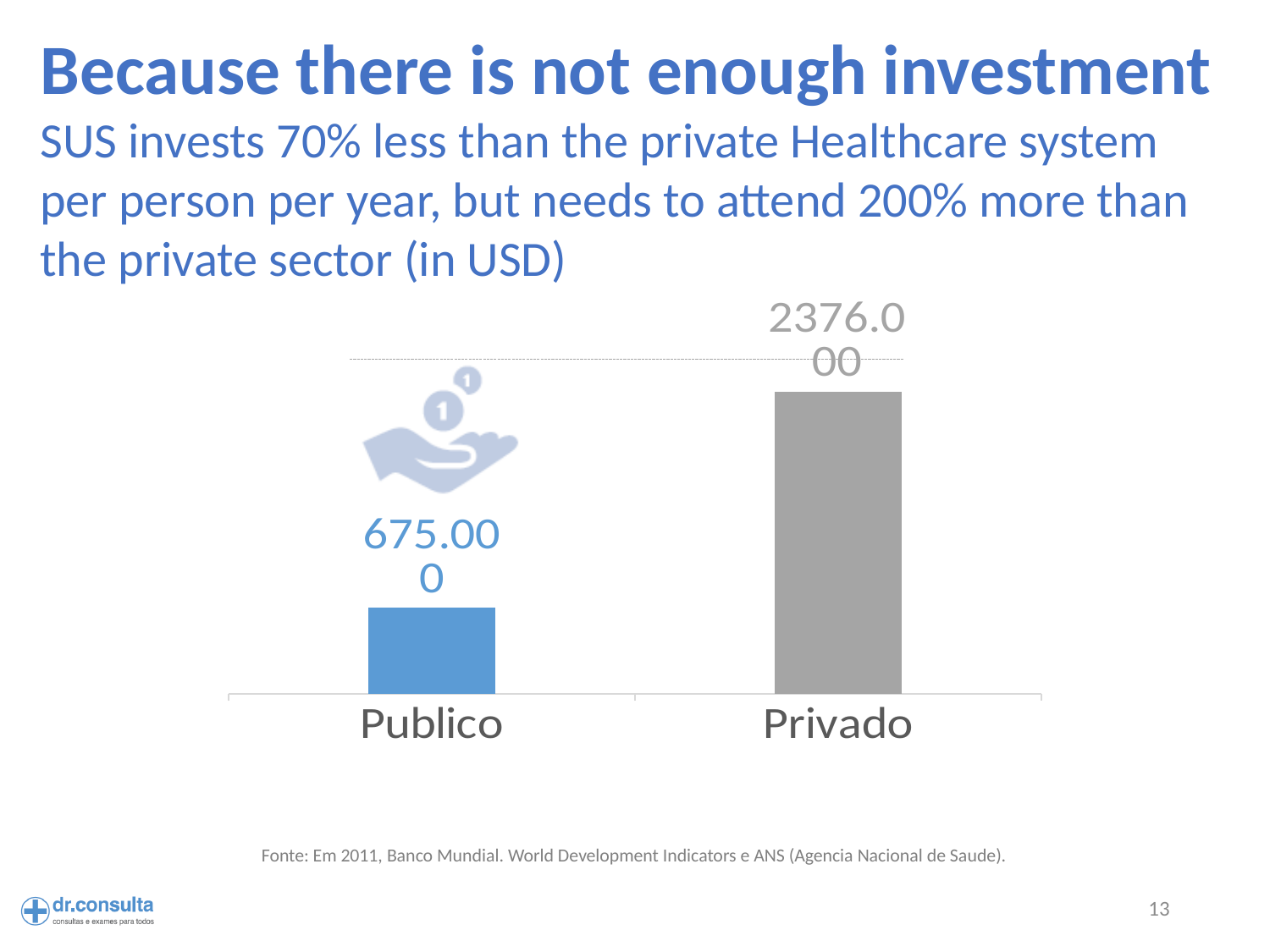
What colour is the bar for Privado? Gray Which category has the highest value? Privado What colour is the bar for Publico? Blue What is the value for Publico? 675.000 What is the value for Privado? 2376.000 What is the difference between the values for Privado and Publico? 1701.000 Which category has the lowest value? Publico How many categories are shown in the chart? 2 Which is larger, the value for Publico or the value for Privado? Privado What kind of chart is shown on the slide? Bar chart